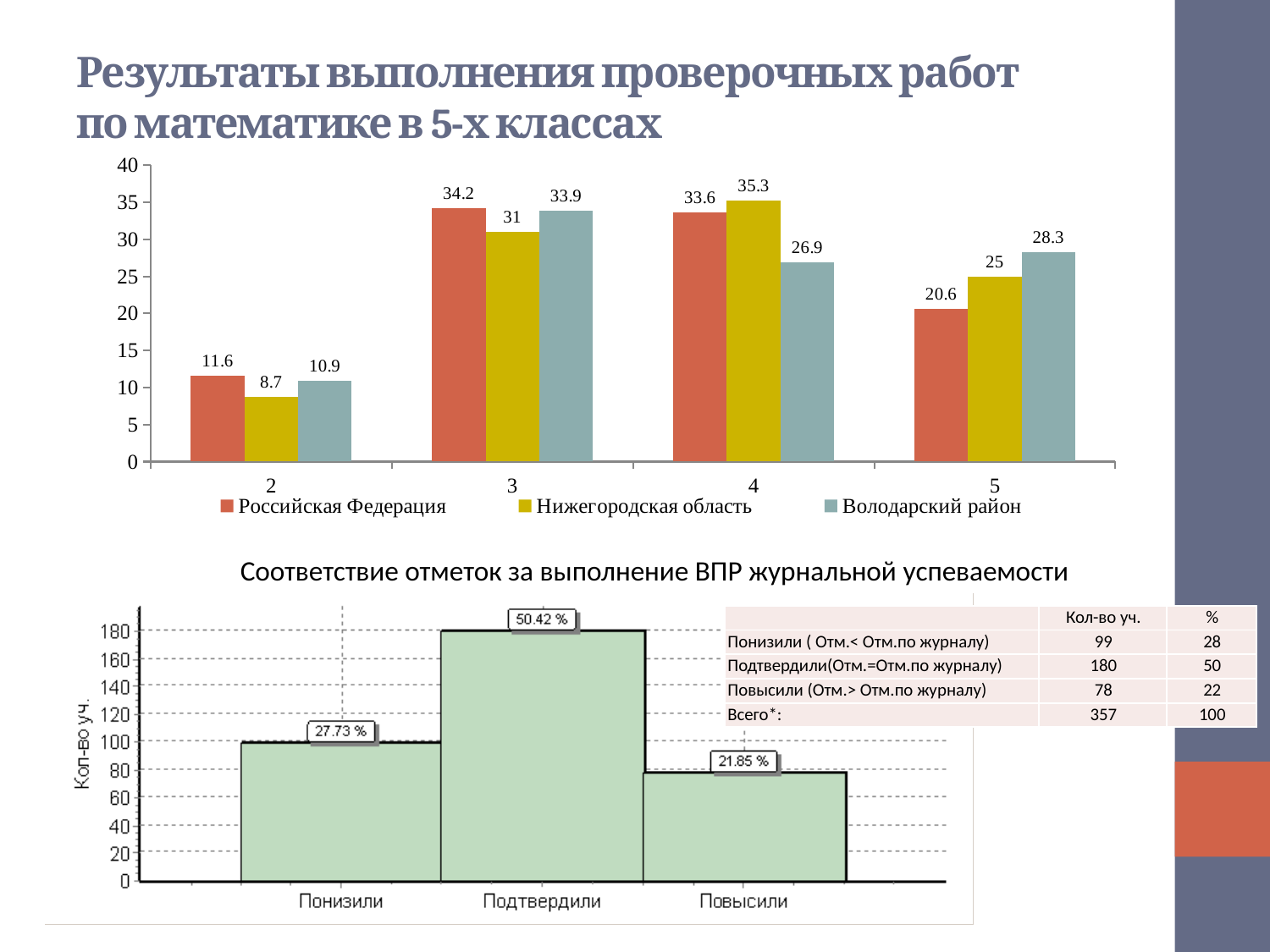
In the bottom chart (Соответствие отметок за выполнение ВПР журнальной успеваемости), what percentage is shown for Подтвердили? 50.42 % In the top chart, which category has the highest value for Володарский район? 3 In the top chart, which category has the lowest value for Нижегородская область? 2 How many series does the legend of the top chart list? 3 In the top chart, what is the value for Российская Федерация in category 5? 20.6 In the top chart, which is larger in category 5: Нижегородская область or Володарский район? Володарский район How many categories are shown on the x axis of the top chart? 4 In the top chart, what is the value for Нижегородская область in category 4? 35.3 In the bottom chart, which category has the lowest bar? Повысили In the top chart, what is the difference between Российская Федерация and Нижегородская область in category 3? 3.2 In the top chart, what is the value for Володарский район in category 2? 10.9 What type of chart is the bottom chart? bar chart